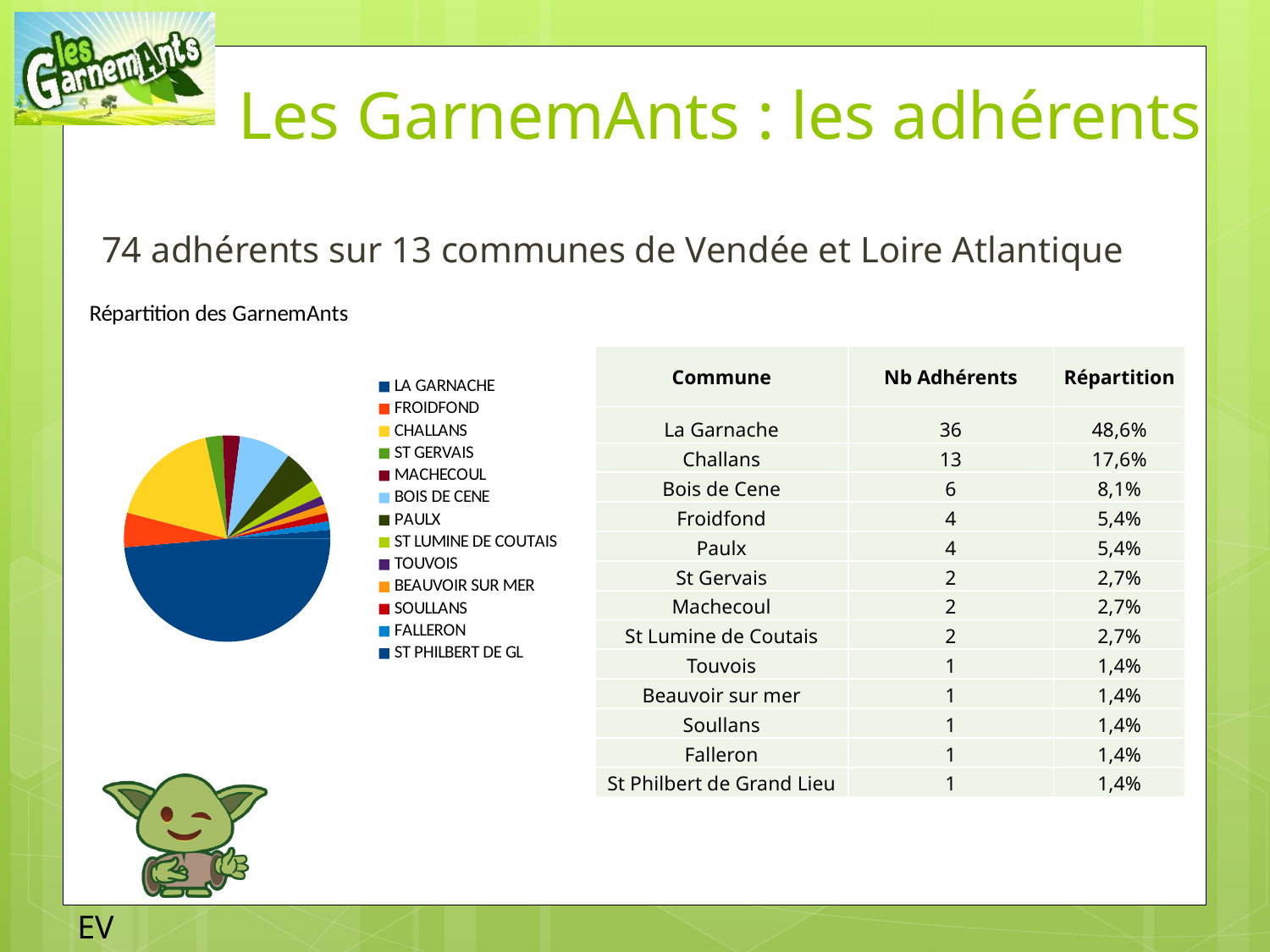
What is the difference in number of adhérents between La Garnache and Challans? 23 What share of the pie does La Garnache represent, according to the table? 48,6% What is the total number of adhérents shown on the slide? 74 What colour is the La Garnache slice in the pie chart? dark blue How many communes does the pie chart legend list? 13 What is the title of the pie chart? Répartition des GarnemAnts How many adhérents does Paulx have? 4 What is the répartition for Bois de Cene? 8,1% Which slice is larger in the pie chart, Challans or Froidfond? Challans Which commune has the largest slice of the pie chart? La Garnache What kind of chart is shown on the slide? pie chart How many adhérents does Challans have, according to the table? 13